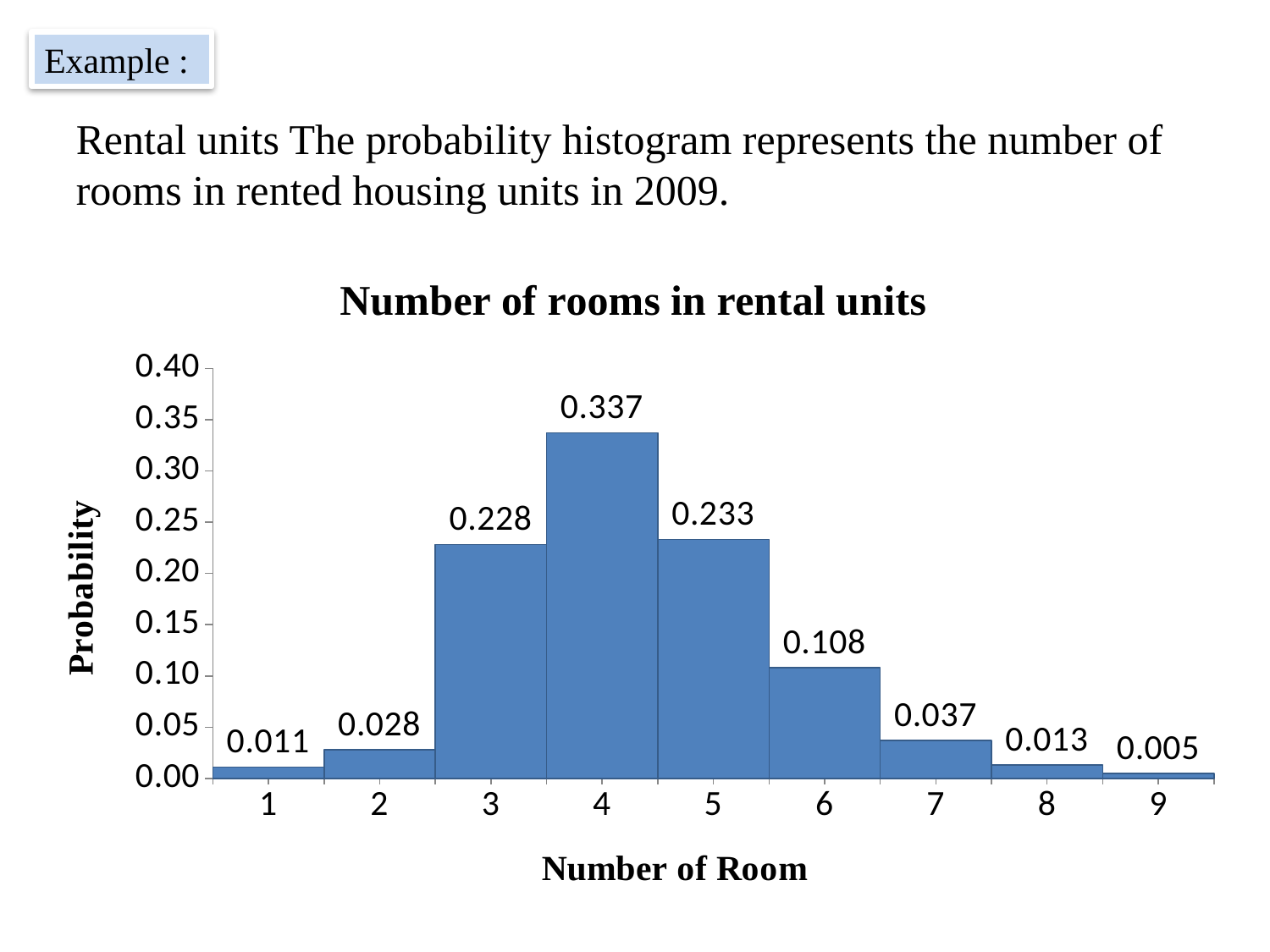
What is the title of the chart? Number of rooms in rental units What is the probability for 1 room? 0.011 Do the probabilities rise or fall from 4 rooms to 9 rooms? fall How many room categories are shown on the x axis? 9 What is the probability for 4 rooms? 0.337 What is the probability for 7 rooms? 0.037 Which number of rooms has the highest probability? 4 Is the probability for 6 rooms greater or less than 0.10? greater What is the difference between the probabilities for 4 rooms and 5 rooms? 0.104 Which number of rooms has the lowest probability? 9 What kind of chart is shown on the slide? bar chart Which has a higher probability, 3 rooms or 5 rooms? 5 rooms